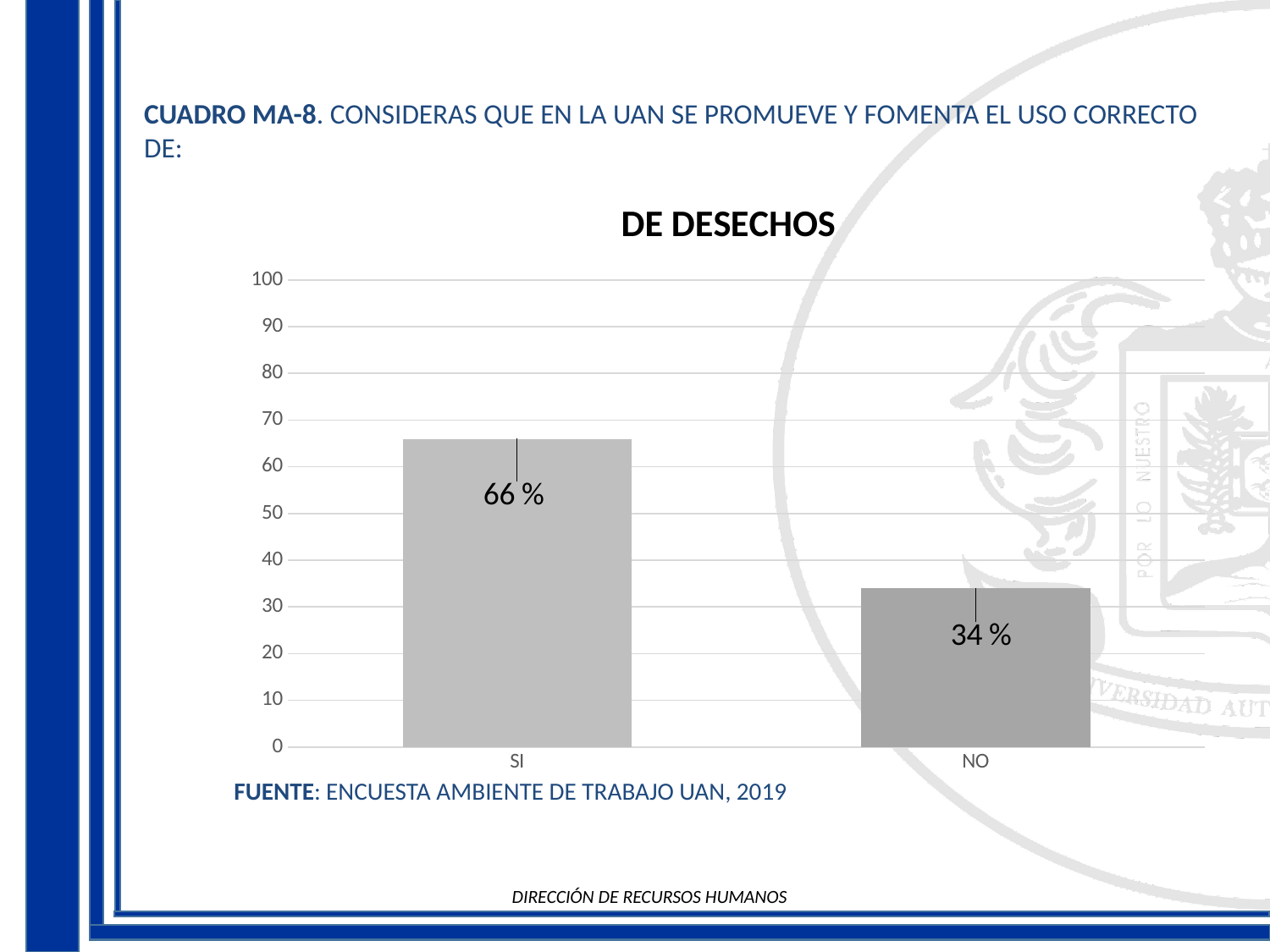
What is the maximum value shown on the vertical axis? 100 How many categories are shown on the x axis? 2 Which category has the highest value? SI Which is larger, the value for SI or the value for NO? SI Is the value for SI greater or less than 60? greater What kind of chart is shown on the slide? bar chart Is the value for NO greater or less than 40? less What is the title of the chart? DE DESECHOS What is the value for NO? 34 % What is the difference between the values for SI and NO? 32 % What is the value for SI? 66 % Which category has the lowest value? NO